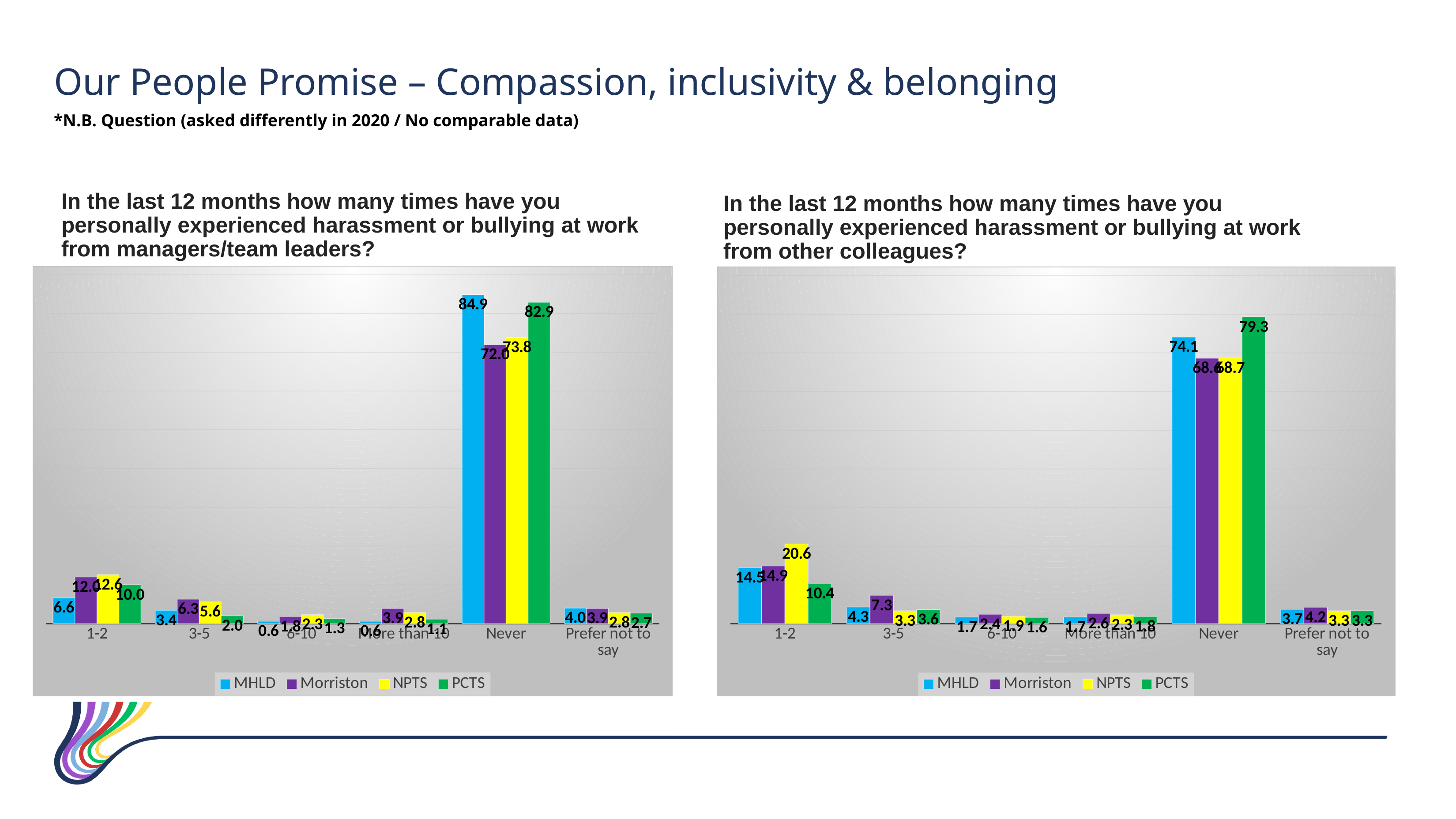
In the chart about harassment or bullying from other colleagues, what is the value for NPTS in the 1-2 category? 20.6 How many series does the legend list in the chart about harassment or bullying from other colleagues? 4 In the chart about harassment or bullying from other colleagues, what is the difference between the PCTS and MHLD values in the Never category? 5.2 In the chart about harassment or bullying from managers/team leaders, which series has the highest value in the Never category? MHLD In the chart about harassment or bullying from other colleagues, which is larger in the 3-5 category: MHLD or Morriston? Morriston In the chart about harassment or bullying from managers/team leaders, what is the difference between the MHLD and Morriston values in the Never category? 12.9 In the chart about harassment or bullying from managers/team leaders, what is the value for MHLD in the Never category? 84.9 In the chart about harassment or bullying from other colleagues, which series has the highest value in the 1-2 category? NPTS In the chart about harassment or bullying from managers/team leaders, what is the value for Morriston in the 3-5 category? 6.3 In the chart about harassment or bullying from managers/team leaders, what is the value for PCTS in the Never category? 82.9 What type of chart is used for the question about harassment or bullying from managers/team leaders? Bar chart In the chart about harassment or bullying from other colleagues, what is the value for PCTS in the Never category? 79.3